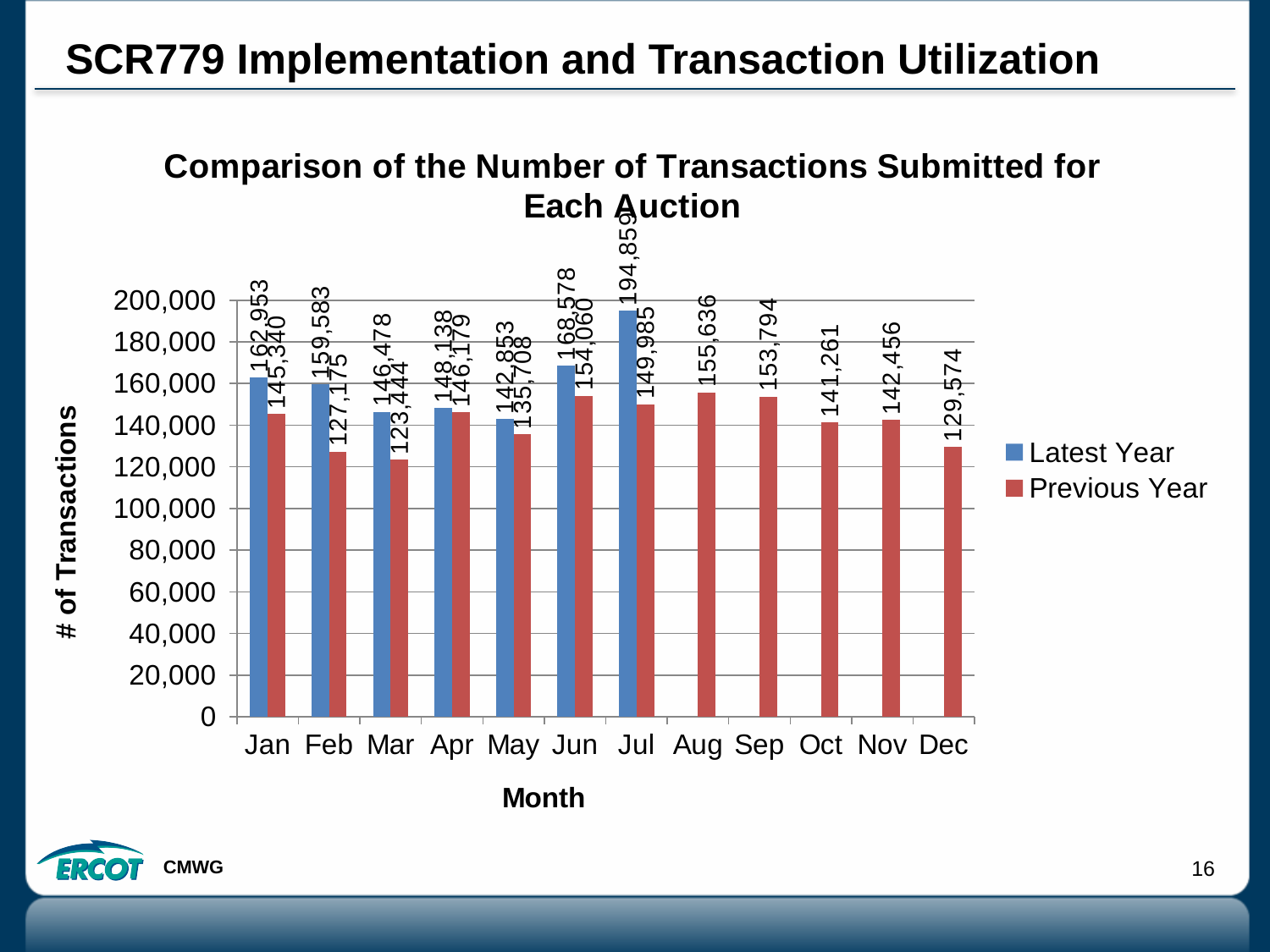
What is the Latest Year value for Jul? 194,859 What is the difference between the Latest Year and Previous Year values for Jan? 17,613 Which month has the lowest Previous Year value? Mar Which is larger, the Latest Year value for Feb or the Previous Year value for Feb? Latest Year How many months have a Latest Year bar? 7 Which month has the highest Previous Year value? Aug What is the Previous Year value for Mar? 123,444 What kind of chart is shown on the slide? Bar chart Which month has the highest Latest Year value? Jul What is the Previous Year value for Dec? 129,574 What is the difference between the Latest Year and Previous Year values for Jul? 44,874 How many series does the legend list? 2